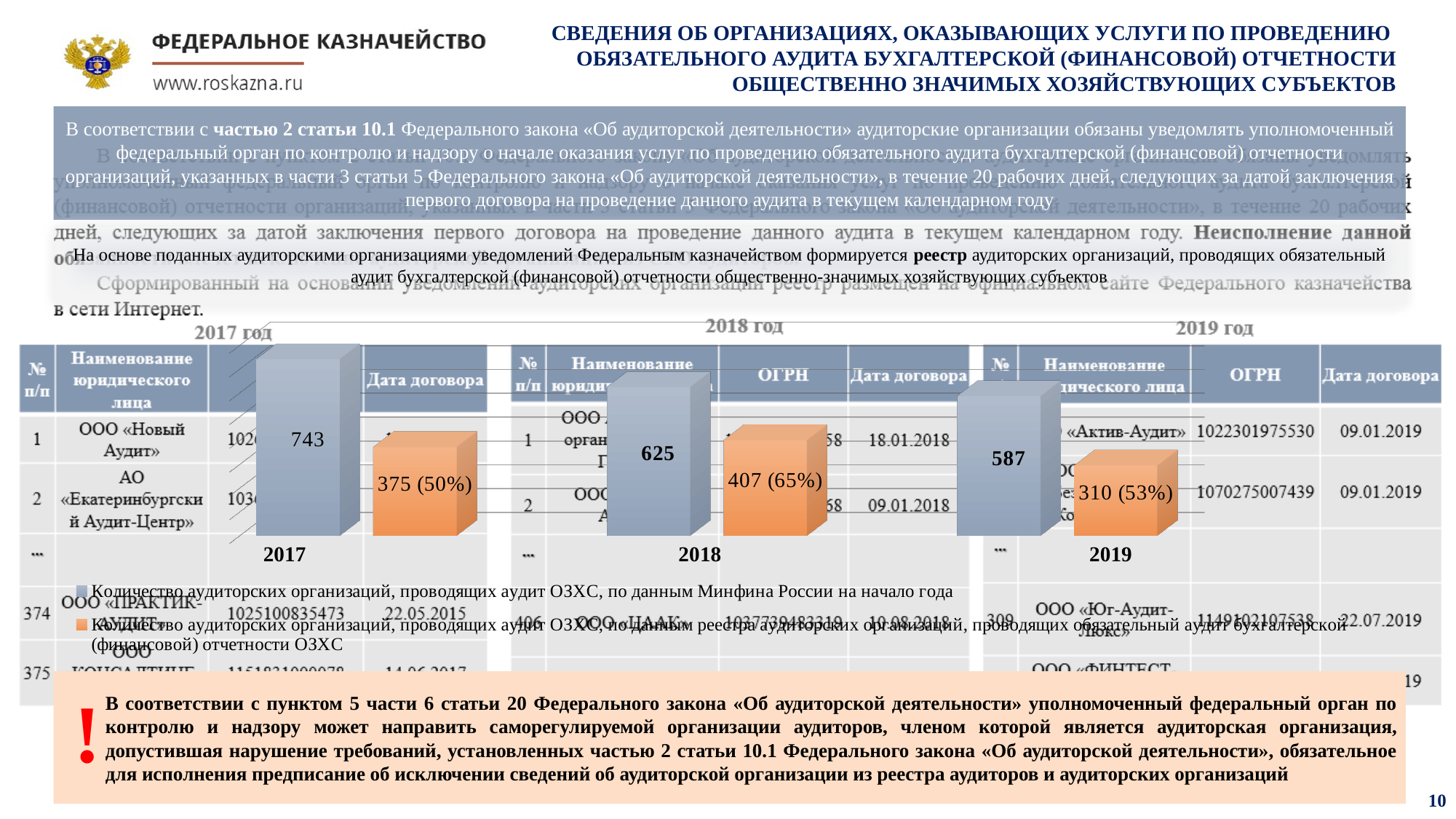
What is the data label of the orange series (по данным реестра) for 2019? 310 (53%) In which year is the orange series (по данным реестра) lowest? 2019 How many series does the chart legend list? 2 How many year categories are plotted on the chart? 3 What is the data label of the orange series (по данным реестра) for 2018? 407 (65%) In which year is the blue series (по данным Минфина России) highest? 2017 What type of chart is shown on the slide? bar chart What is the value of the blue series (по данным Минфина России) for 2017? 743 Does the blue series (по данным Минфина России) rise or fall from 2017 to 2019? fall What is the value of the blue series (по данным Минфина России) for 2019? 587 What is the difference between the blue and orange values for 2017? 368 Which is larger in 2018: the blue series value or the orange series value? blue series (625)